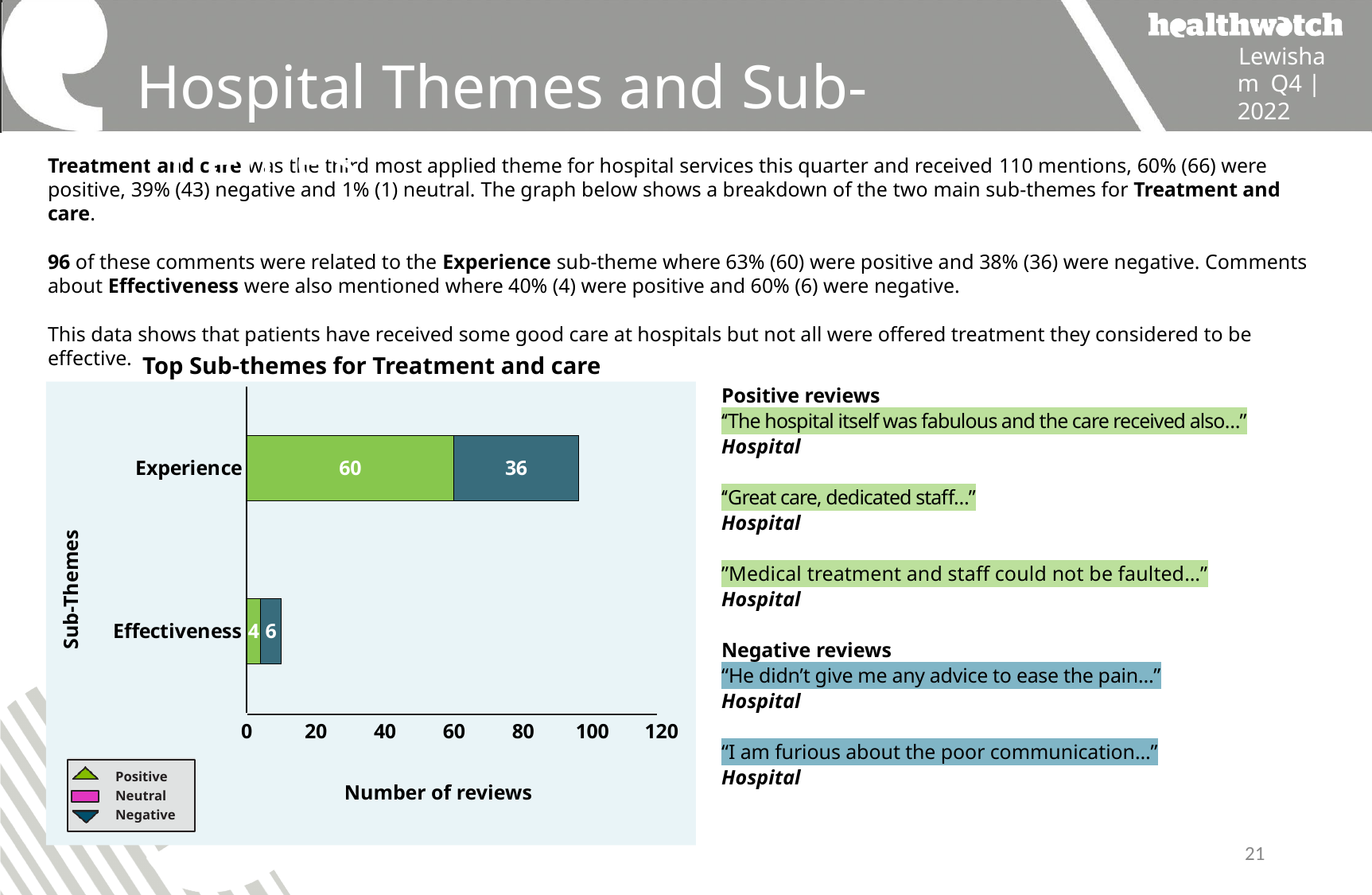
What is the difference between positive and negative reviews for the Experience sub-theme? 24 For the Effectiveness sub-theme, are there more positive or negative reviews? Negative How many negative reviews are shown for the Effectiveness sub-theme? 6 How many series does the legend list? 3 What type of chart is shown on the slide? Stacked bar chart Which sub-theme has the most reviews in total? Experience What is the total number of reviews for the Experience bar? 96 What is the title of the chart? Top Sub-themes for Treatment and care How many positive reviews are shown for the Effectiveness sub-theme? 4 How many negative reviews are shown for the Experience sub-theme? 36 What is the total number of reviews for the Effectiveness bar? 10 How many positive reviews are shown for the Experience sub-theme? 60